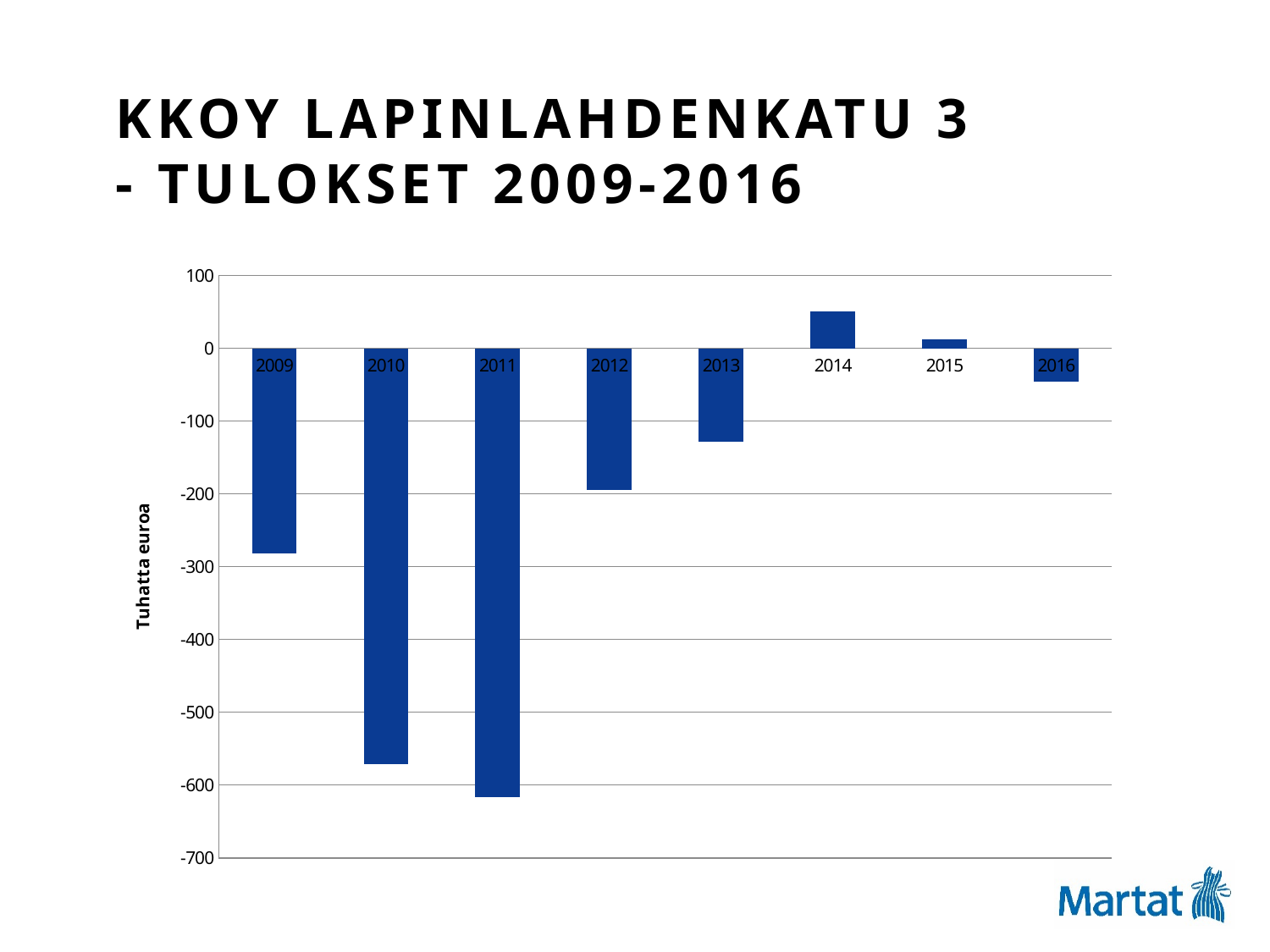
Is the value for 2009 greater or less than -200? less Do the values rise or fall from 2011 to 2014? rise Is the value for 2016 greater or less than 0? less What is the label on the vertical axis of the chart? Tuhatta euroa Which year has the highest value in the chart? 2014 Is the value for 2010 greater or less than -500? less How many years (bars) are plotted in the chart? 8 Which year has the larger value, 2009 or 2012? 2012 What kind of chart is shown on the slide? bar chart Which year has the lowest value in the chart? 2011